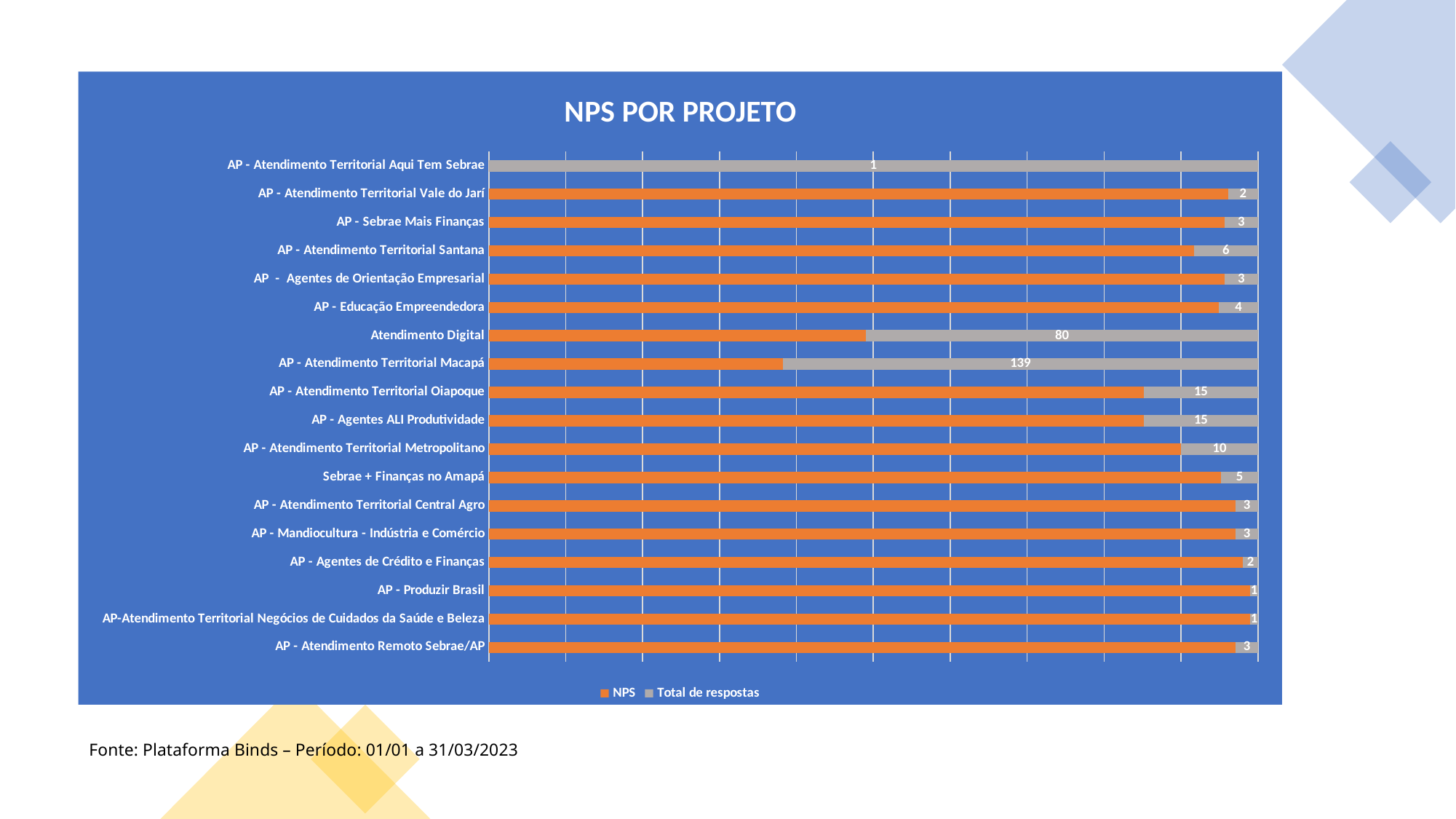
How many series does the legend list? 2 What is the difference in Total de respostas between AP - Atendimento Territorial Macapá and Atendimento Digital? 59 What is the title of the chart? NPS POR PROJETO What is the Total de respostas value for Sebrae + Finanças no Amapá? 5 What is the Total de respostas value for AP - Atendimento Territorial Macapá? 139 What is the Total de respostas value for AP - Atendimento Territorial Santana? 6 What is the Total de respostas value for Atendimento Digital? 80 What is the Total de respostas value for AP - Atendimento Territorial Metropolitano? 10 Which project has the highest Total de respostas? AP - Atendimento Territorial Macapá What kind of chart is shown on the slide? bar chart Which has a larger Total de respostas: AP - Atendimento Territorial Oiapoque or AP - Atendimento Territorial Metropolitano? AP - Atendimento Territorial Oiapoque How many projects (categories) are shown in the chart? 18